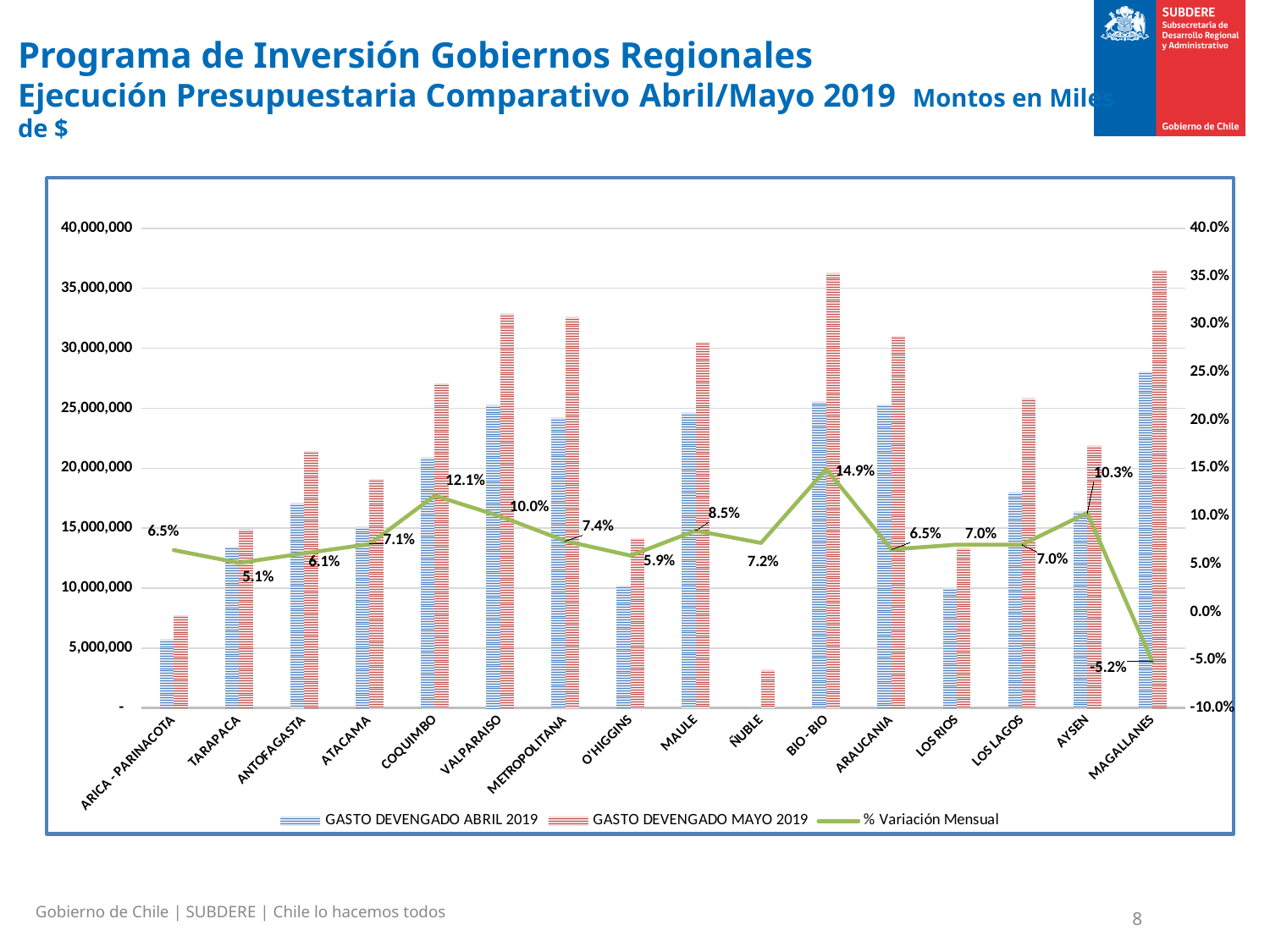
What is the % Variación Mensual value for BIO-BIO? 14.9% What kind of chart is shown on the slide? Combination bar and line chart How many series does the chart legend list? 3 What is the % Variación Mensual value for MAGALLANES? -5.2% How many regions are shown on the x axis of the chart? 16 What is the difference in % Variación Mensual between BIO-BIO and MAGALLANES? 20.1 percentage points What is the % Variación Mensual value for COQUIMBO? 12.1% Is the GASTO DEVENGADO MAYO 2019 value for ÑUBLE greater or less than 5,000,000? less Which has a larger % Variación Mensual, COQUIMBO or AYSEN? COQUIMBO Which region has the highest % Variación Mensual? BIO-BIO Which region has the lowest % Variación Mensual? MAGALLANES Is the GASTO DEVENGADO MAYO 2019 value for BIO-BIO greater or less than 35,000,000? greater